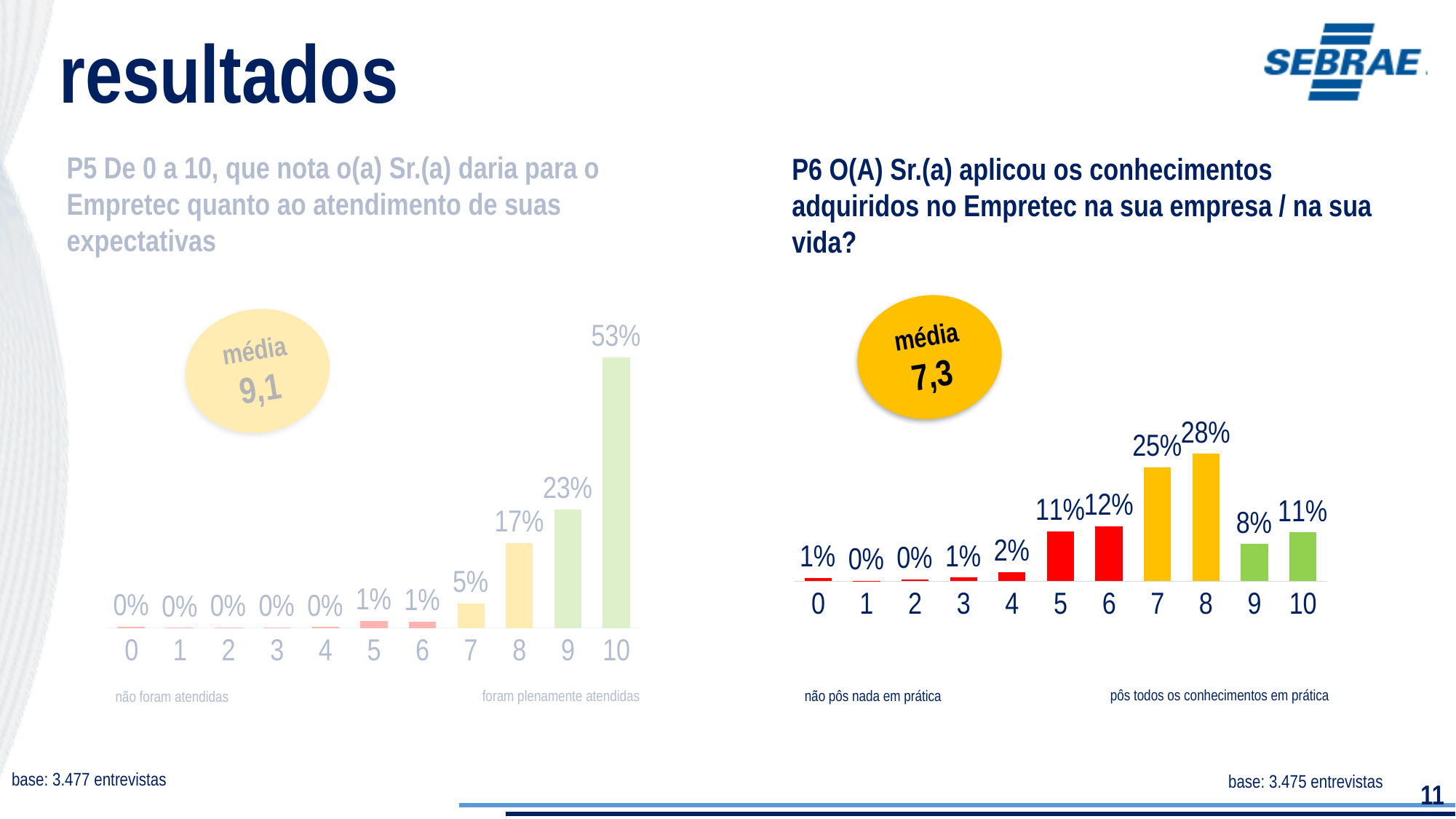
In the P5 chart on the left, what percentage is shown for score 8? 17% In the P6 chart on the right, which score has the highest percentage? 8 In the P6 chart on the right, what percentage is shown for score 8? 28% What average (média) is shown in the circle for the P5 chart on the left? 9,1 In the P6 chart on the right, which is larger: the percentage for score 5 or for score 9? score 5 In the P5 chart on the left, which score has the highest percentage? 10 How many score categories are shown on the x axis of the P6 chart on the right? 11 What type of chart is used for the P6 question on the right? bar chart In the P6 chart on the right, what is the difference between the percentages for score 8 and score 7? 3% In the P5 chart on the left, what is the difference between the percentages for score 10 and score 9? 30% In the P5 chart on the left, what percentage is shown for score 10? 53% What average (média) is shown in the circle for the P6 chart on the right? 7,3